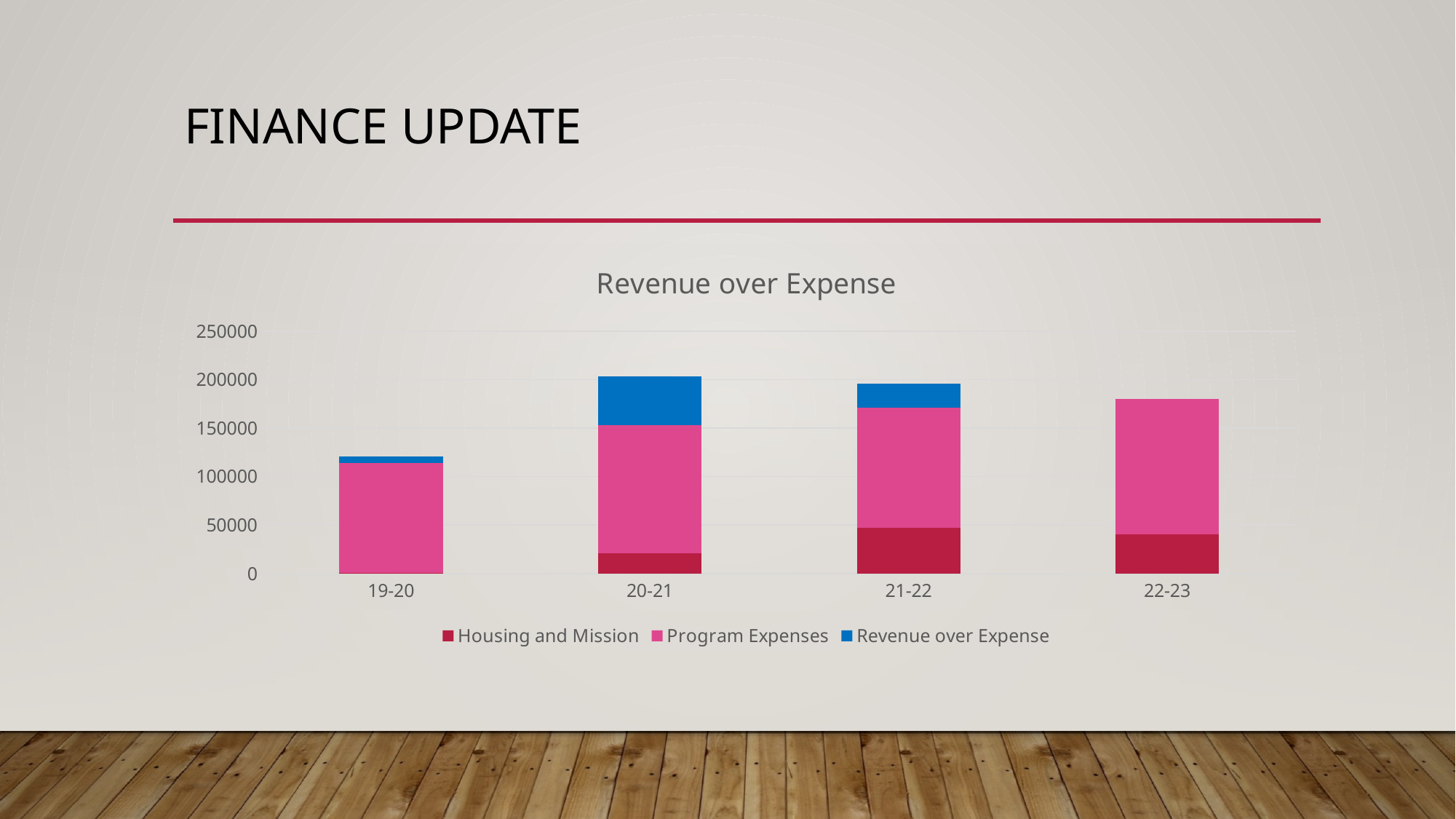
Which category has the tallest stacked bar overall? 20-21 Which has the larger total stacked bar, 19-20 or 22-23? 22-23 Which series is shown in blue in the legend? Revenue over Expense Which category has the largest Revenue over Expense segment, 20-21 or 21-22? 20-21 Is the Housing and Mission value for 22-23 greater or less than 50000? less How many categories are shown on the x axis? 4 Which category has the shortest stacked bar overall? 19-20 What kind of chart is shown on the slide? bar chart What is the title of the chart? Revenue over Expense Is the total stacked value for 22-23 greater or less than 200000? less How many series does the legend list? 3 Is the total stacked value for 19-20 greater or less than 100000? greater